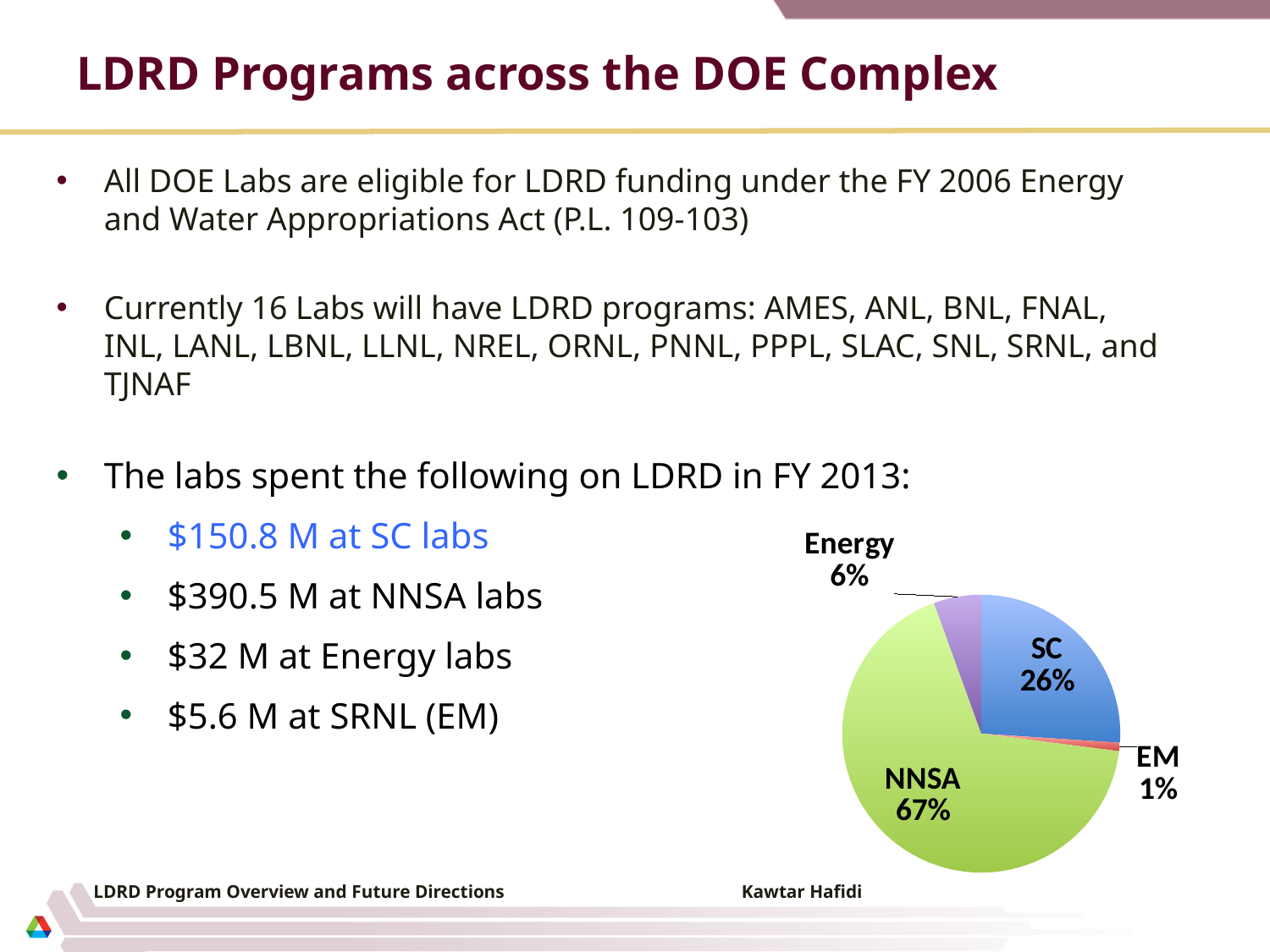
Which slice of the pie chart is the smallest? EM What is the difference in percentage points between the Energy and EM slices? 5 What share of the pie does SC represent? 26% What share of the pie does Energy represent? 6% How many slices does the pie chart have? 4 What share of the pie does NNSA represent? 67% Which slice is larger, SC or Energy? SC What is the difference in percentage points between the NNSA and SC slices? 41 Which slice of the pie chart is the largest? NNSA What colour is the NNSA slice of the pie chart? green What kind of chart is shown on the slide? pie chart